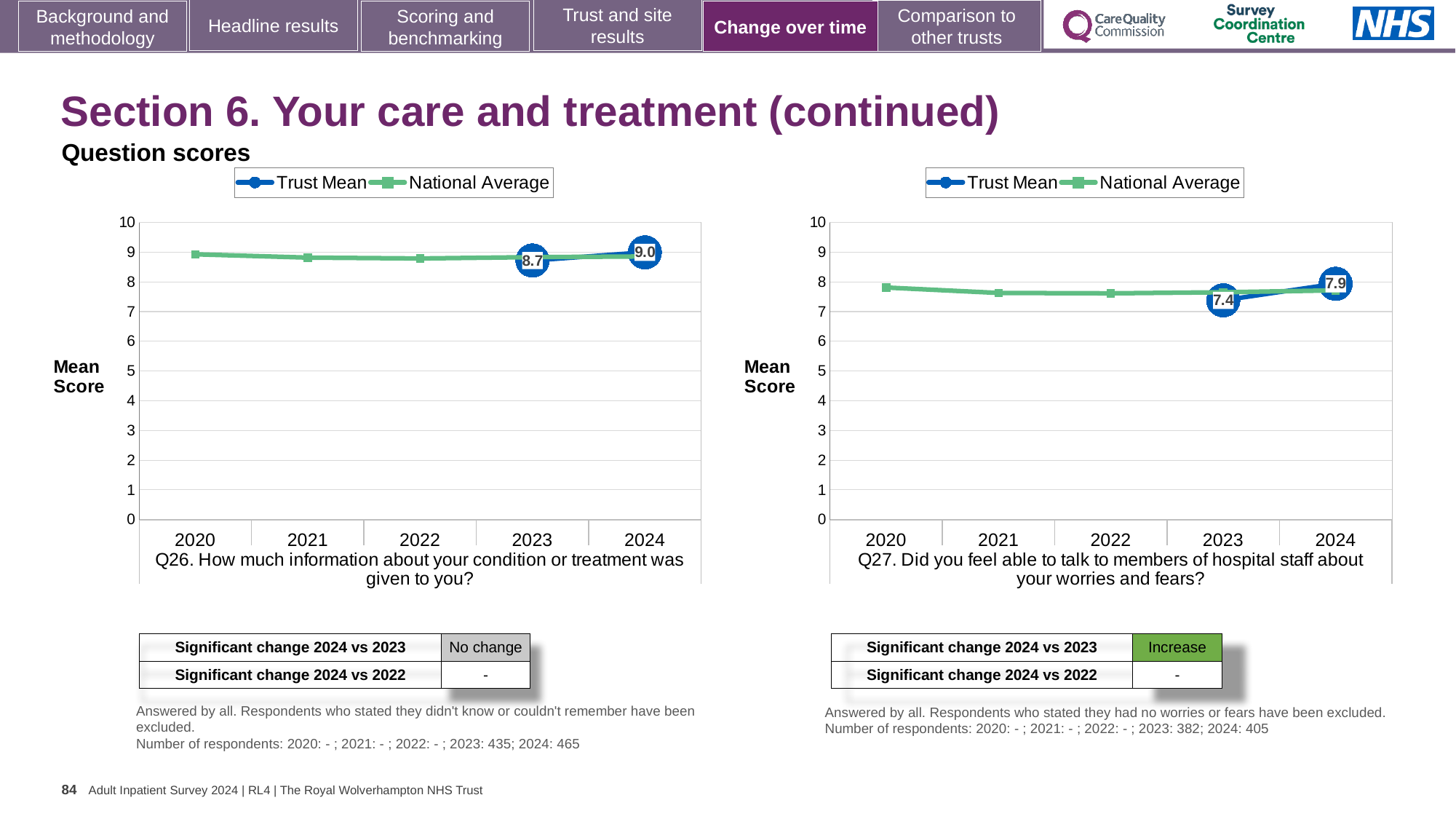
How many years are shown on the x axis of the Q27 chart on the right? 5 In the Q27 chart on the right, what is the difference between the Trust Mean for 2024 and 2023? 0.5 In the Q26 chart on the left, is the National Average for 2020 greater or less than 8? greater How many series does the legend of the Q27 chart on the right list? 2 In the Q26 chart on the left, by how much did the Trust Mean change from 2023 to 2024? 0.3 In the Q27 chart on the right, what is the Trust Mean score for 2023? 7.4 In the Q27 chart on the right, which year has the higher Trust Mean, 2023 or 2024? 2024 In the Q26 chart on the left, what is the Trust Mean score for 2023? 8.7 What kind of chart is the Q26 chart on the left? line chart In the Q27 chart on the right, what is the Trust Mean score for 2024? 7.9 In the Q26 chart on the left, does the Trust Mean rise or fall from 2023 to 2024? rise In the Q26 chart on the left, what is the Trust Mean score for 2024? 9.0